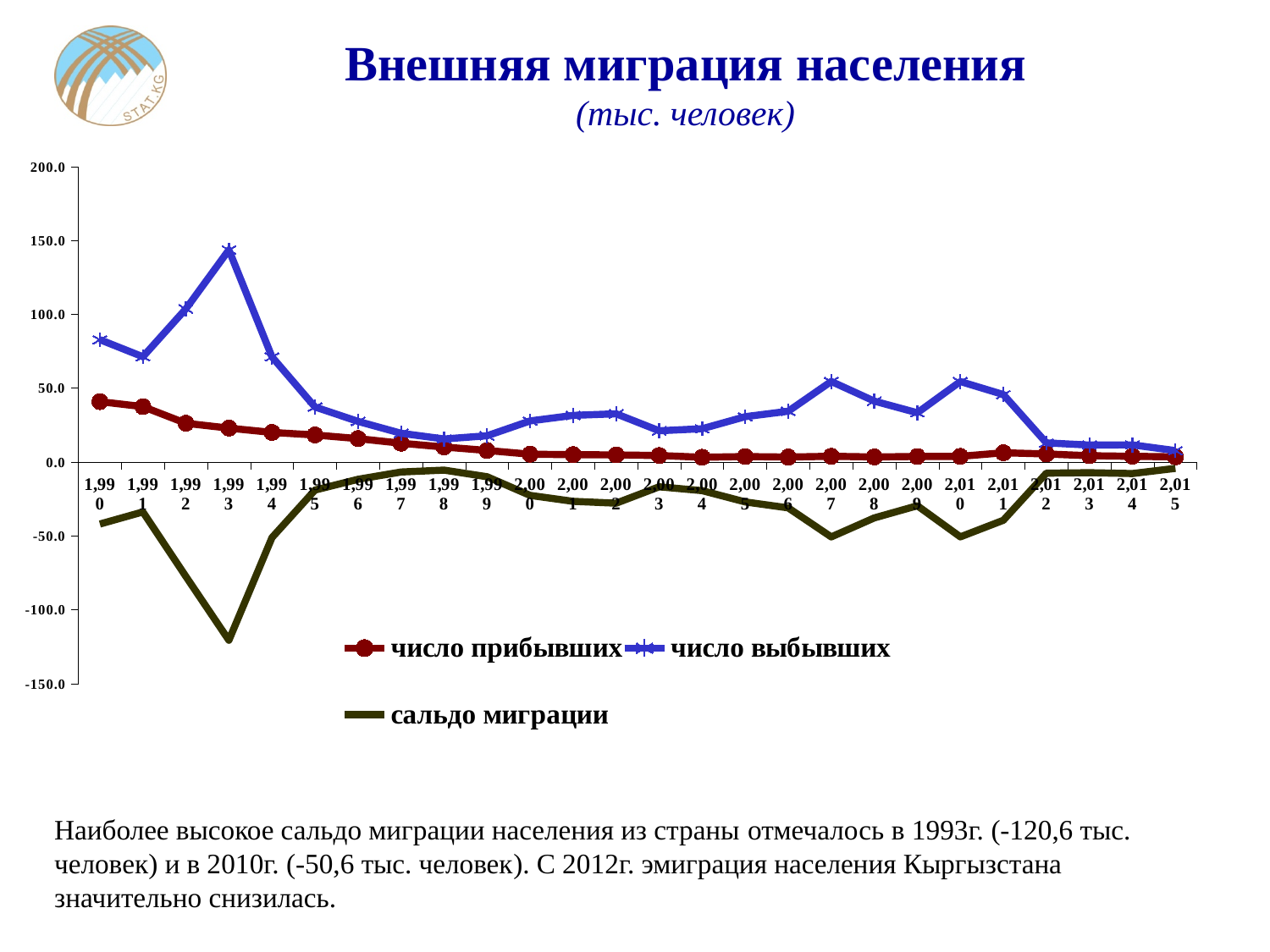
What are the three series named in the legend? число прибывших, число выбывших, сальдо миграции In which year does the series 'сальдо миграции' reach its lowest value? 1993 How many years are plotted along the x axis? 26 Is the value for 'сальдо миграции' in 1993 greater or less than -100.0? less In which year does the series 'число выбывших' reach its highest value? 1993 Is the value for 'число прибывших' in 1990 greater or less than 50.0? less How many series does the legend list? 3 In 1990, which is larger: 'число прибывших' or 'число выбывших'? число выбывших Is the value for 'число выбывших' in 1993 greater or less than 100.0? greater What kind of chart is shown on the slide? line chart Does the series 'число прибывших' rise or fall from 1990 to 2000? fall In which year does the series 'число прибывших' reach its highest value? 1990